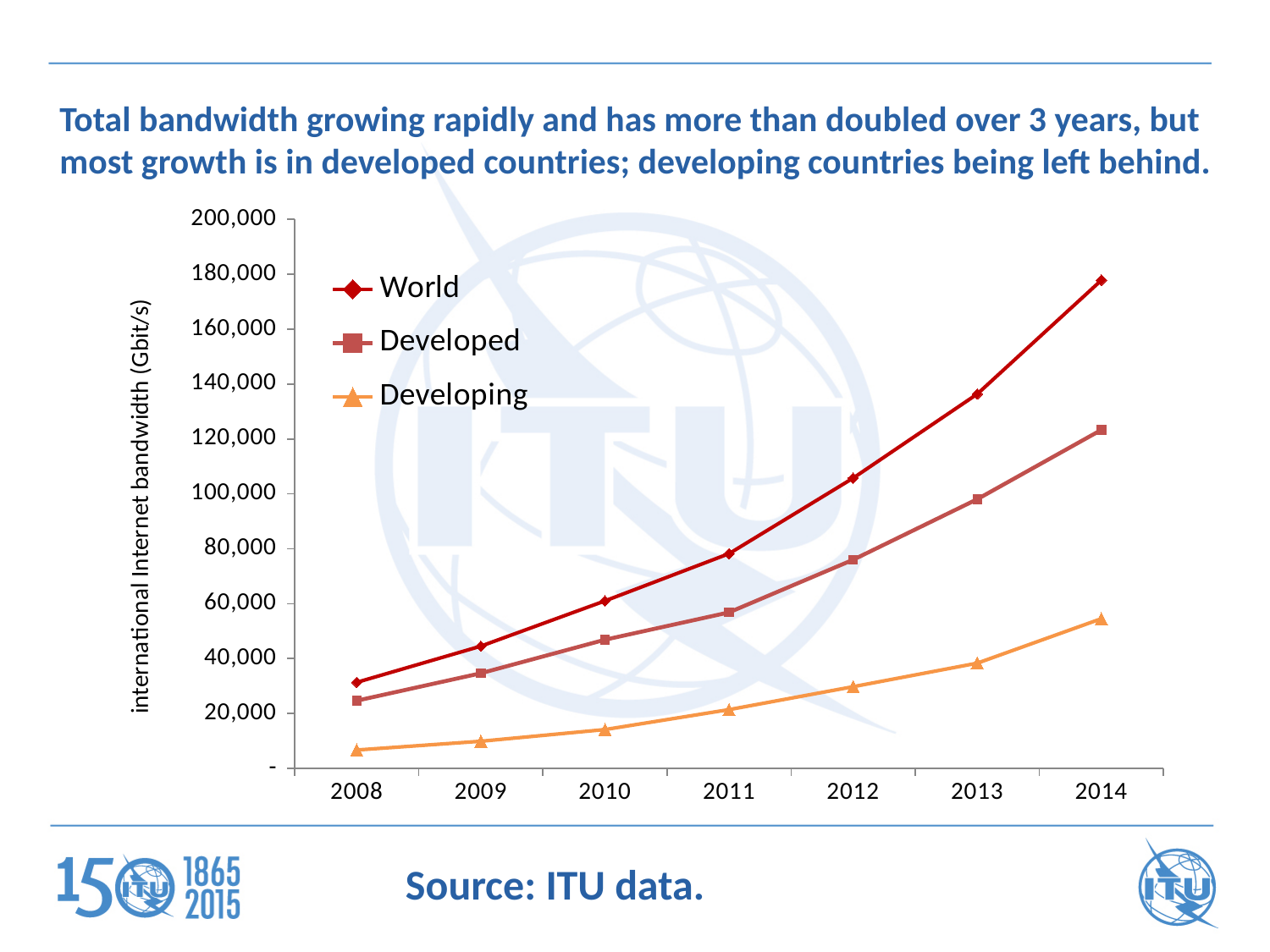
Is the value for World in 2014 greater or less than 160,000? greater How many years are shown on the x axis? 7 Is the value for Developing in 2014 greater or less than 60,000? less Which series has the lowest value in 2014? Developing Is the value for Developing in 2008 greater or less than 20,000? less Which series has the highest value in 2014? World How many series does the legend list? 3 What kind of chart is shown on the slide? line chart What is the label on the vertical axis? international Internet bandwidth (Gbit/s) Does the Developing series rise or fall from 2008 to 2014? rise